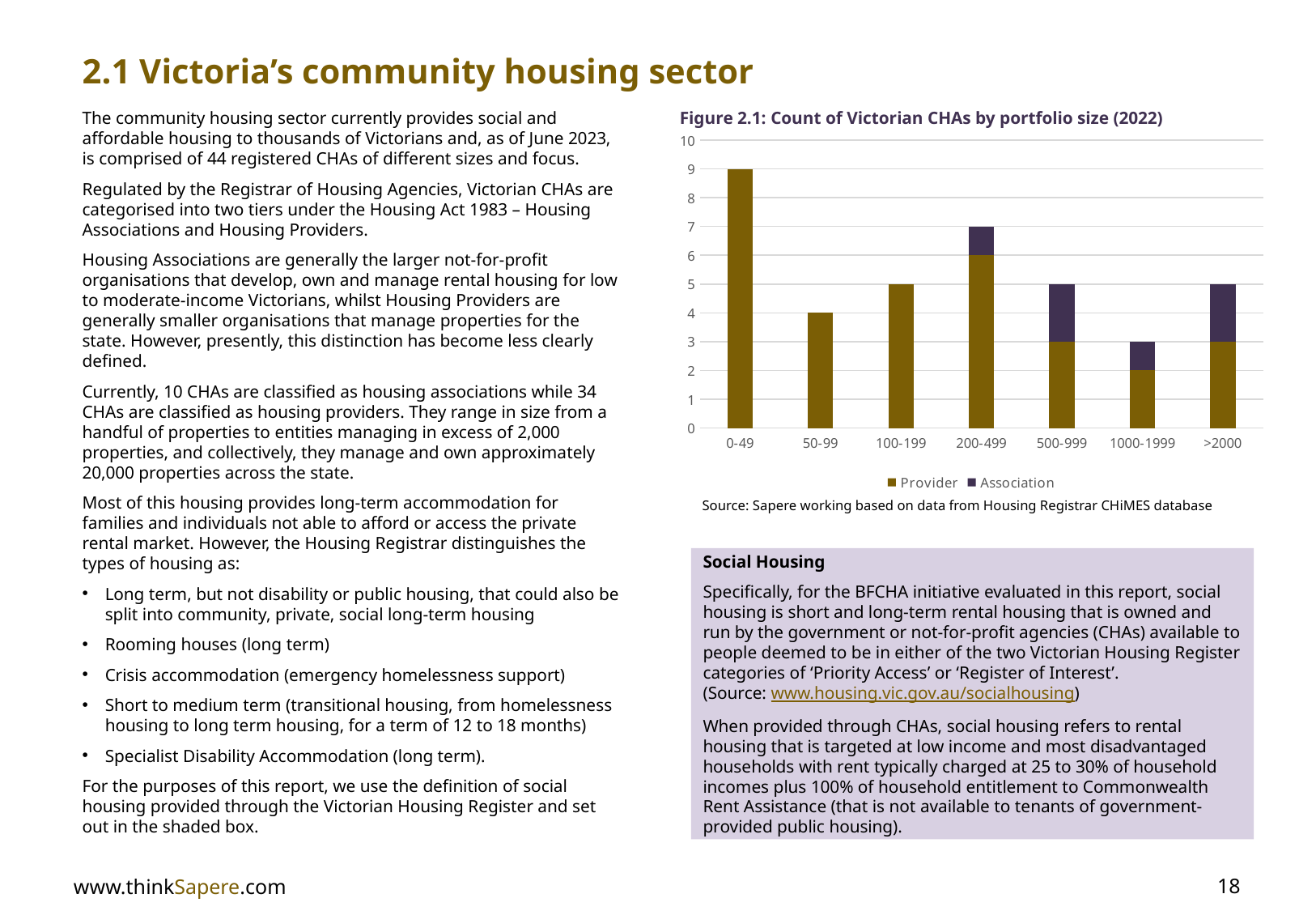
In Figure 2.1, what is the total count of CHAs for the 1000-1999 category? 3 How many series does the legend of Figure 2.1 list? 2 In Figure 2.1, what is the total count of CHAs (Provider plus Association) for the 200-499 category? 7 What kind of chart is Figure 2.1? Stacked bar chart In Figure 2.1, what is the Provider count for the 50-99 portfolio size category? 4 In Figure 2.1, what is the difference between the Provider count for 0-49 and the Provider count for 50-99? 5 In Figure 2.1, which portfolio size category has the lowest total count of CHAs? 1000-1999 In Figure 2.1, what is the Provider count for the 100-199 portfolio size category? 5 In Figure 2.1, what is the Provider count for the 0-49 portfolio size category? 9 In Figure 2.1, is the total count for the 500-999 category greater or less than the total count for the 1000-1999 category? greater In Figure 2.1, which portfolio size category has the highest total count of CHAs? 0-49 How many portfolio size categories are shown on the x axis of Figure 2.1? 7